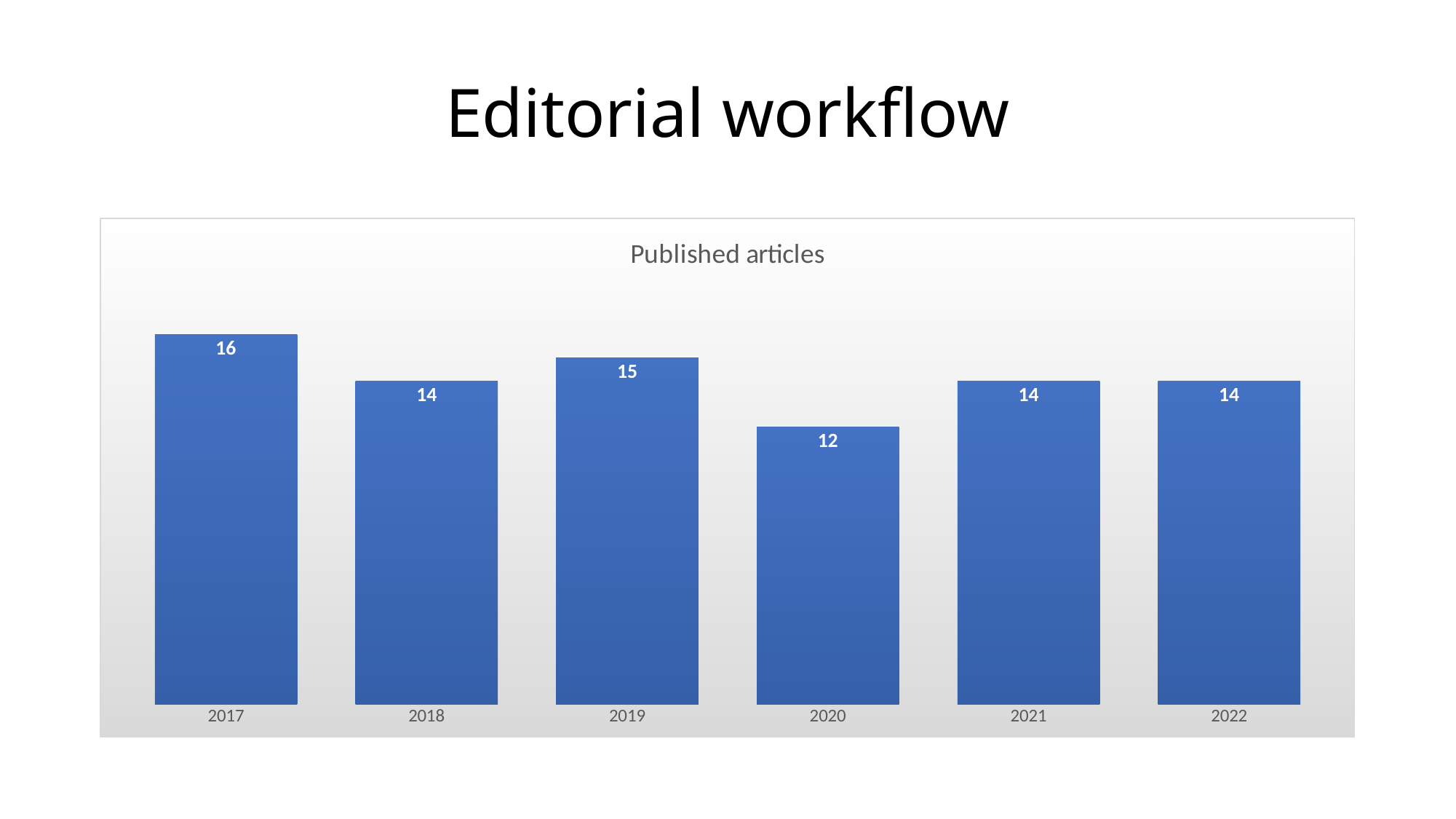
What is the value for 2017 in the Published articles chart? 16 What is the difference between the values for 2019 and 2018? 1 What is the value for 2022 in the Published articles chart? 14 How many years are shown on the x axis of the chart? 6 Which year has the lowest number of published articles? 2020 What kind of chart is shown on the slide? Bar chart What is the title of the chart? Published articles Which is larger, the value for 2019 or the value for 2020? 2019 What is the value for 2019 in the Published articles chart? 15 What is the value for 2020 in the Published articles chart? 12 Which year has the highest number of published articles? 2017 What is the difference between the values for 2017 and 2020? 4